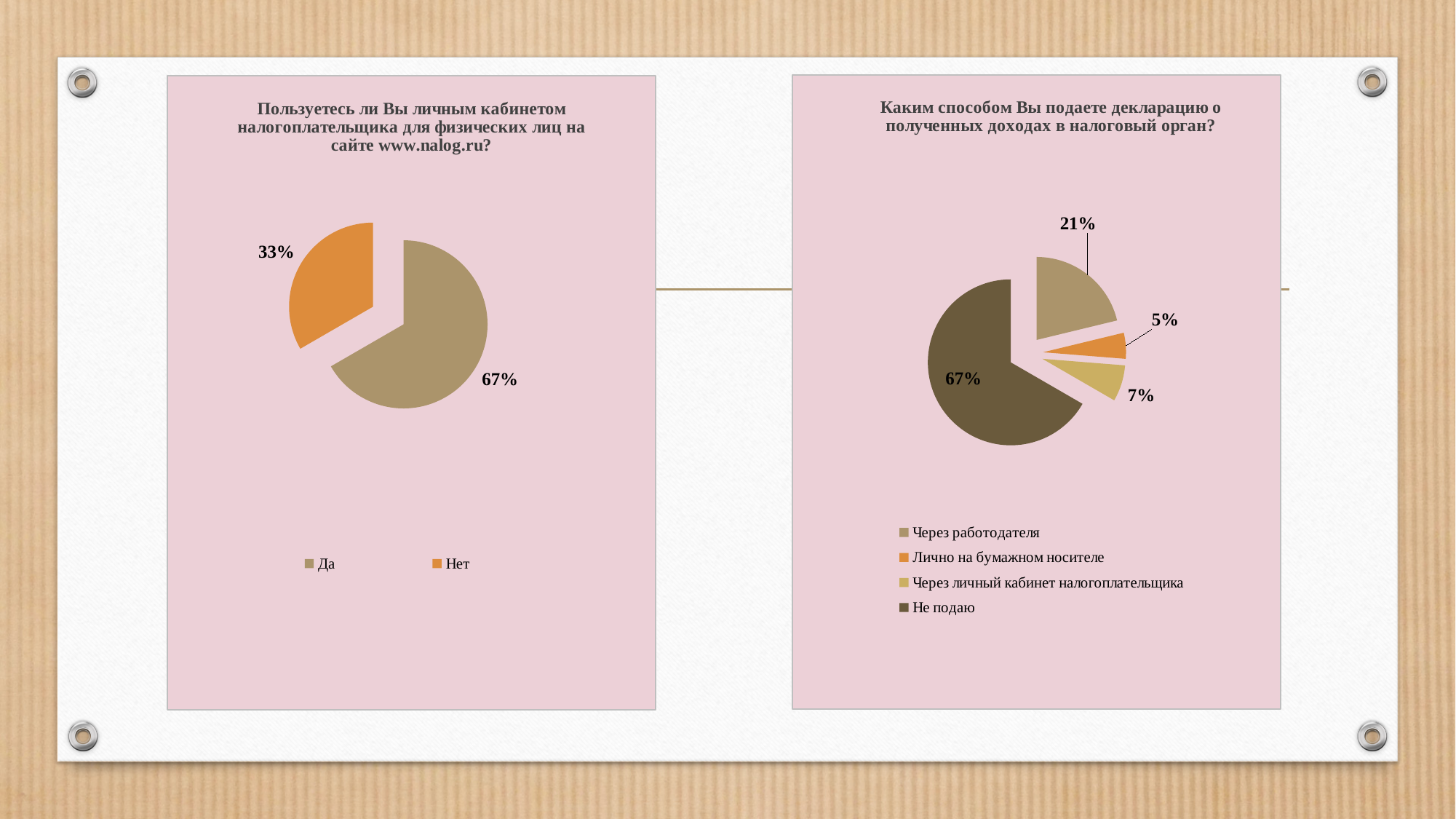
In the left chart (Пользуетесь ли Вы личным кабинетом налогоплательщика...), what share of respondents answered "Да"? 67% In the left chart, what share of respondents answered "Нет"? 33% What type of chart is the left chart? Pie chart How many categories does the legend of the right chart list? 4 In the right chart, what is the difference in percentage points between "Через личный кабинет налогоплательщика" and "Лично на бумажном носителе"? 2 In the right chart (Каким способом Вы подаете декларацию...), what share of respondents chose "Не подаю"? 67% In the right chart, which category has the smallest share? Лично на бумажном носителе In the left chart, which answer has the larger share, "Да" or "Нет"? Да In the left chart, what is the difference in percentage points between "Да" and "Нет"? 34 In the right chart, which category has the largest share? Не подаю In the right chart, what share of respondents chose "Лично на бумажном носителе"? 5% In the right chart, what share of respondents chose "Через работодателя"? 21%